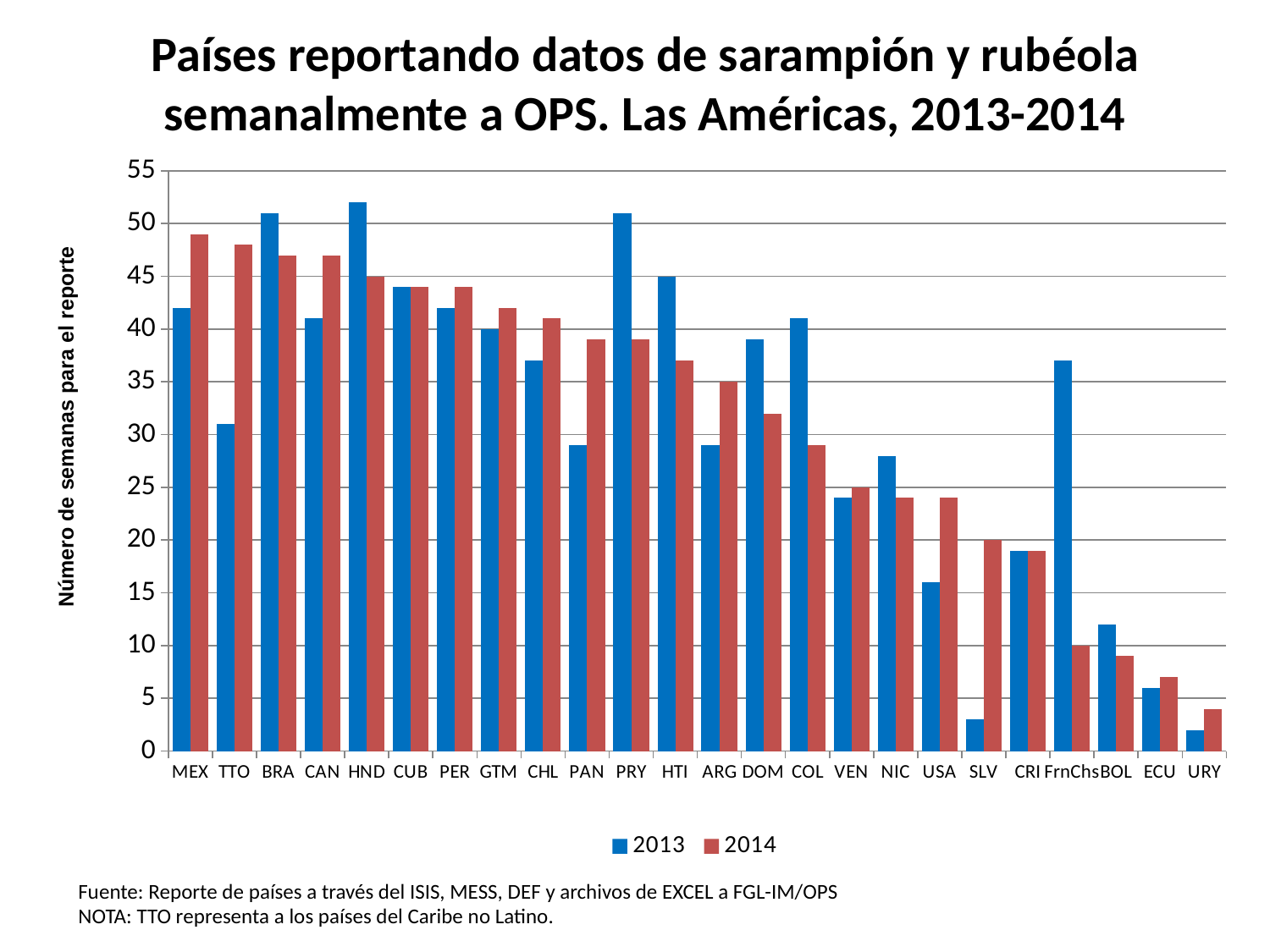
For FrnChs, which series has the larger value, 2013 or 2014? 2013 How many series does the legend list? 2 Which category has the lowest value for 2014? URY Is the 2013 value for SLV greater or less than 5? less Is the 2014 value for MEX greater or less than 45? greater For TTO, which series has the larger value, 2013 or 2014? 2014 How many countries/categories are shown on the x axis? 24 Is the 2014 value for URY greater or less than 5? less What is the label of the vertical axis? Número de semanas para el reporte What kind of chart is shown on the slide? bar chart What is the 2014 value for SLV? 20